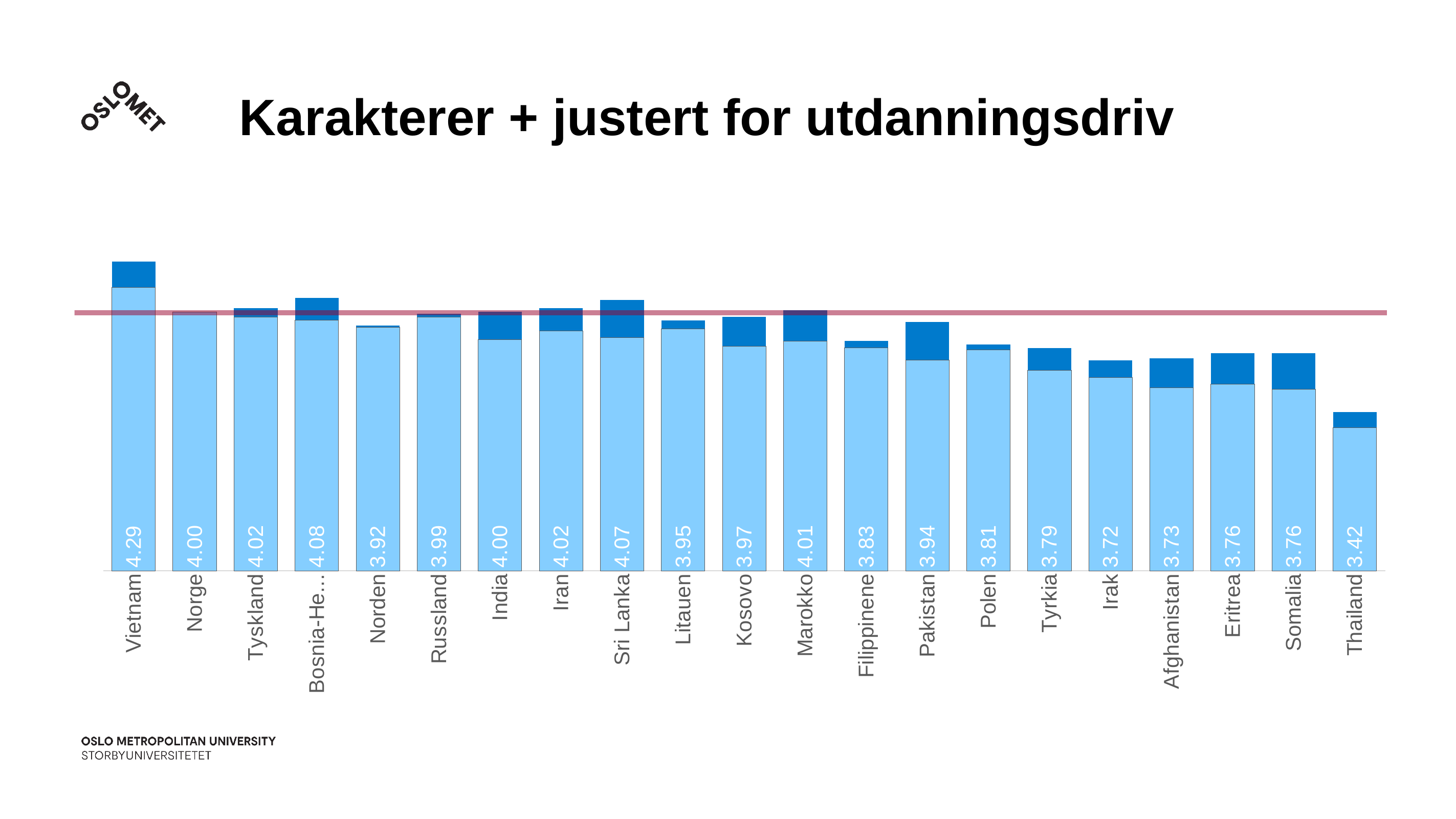
What value is labelled for Pakistan? 3.94 Which category has the lowest labelled value? Thailand How many countries or groups are shown along the x axis of the chart? 21 Which category has the highest labelled value? Vietnam What is the difference between the labelled values for Vietnam and Thailand? 0.87 What value is labelled for Thailand? 3.42 What value is labelled for Sri Lanka? 4.07 What is the title of the chart on the slide? Karakterer + justert for utdanningsdriv What value is labelled for Vietnam? 4.29 What is the difference between the labelled values for Norge and Somalia? 0.24 Which has the larger labelled value, Kosovo or Irak? Kosovo What kind of chart is shown on the slide? bar chart